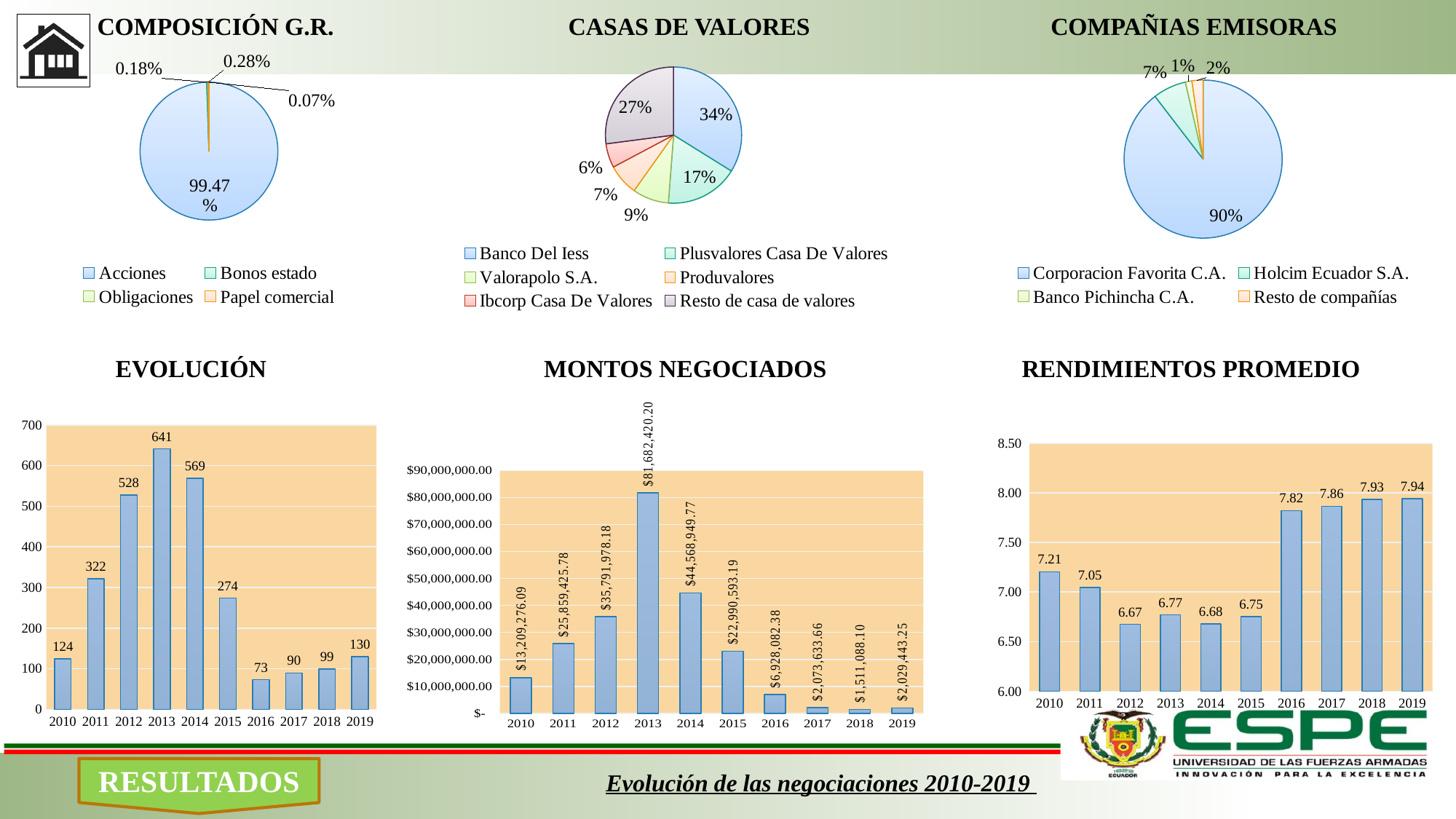
What kind of chart is the EVOLUCIÓN chart? Bar chart In the EVOLUCIÓN chart, which year has the lowest value? 2016 In the RENDIMIENTOS PROMEDIO chart, which is larger, the value for 2010 or the value for 2011? 2010 In the RENDIMIENTOS PROMEDIO chart, what is the value for 2019? 7.94 In the COMPAÑIAS EMISORAS pie chart, what share does Corporacion Favorita C.A. have? 90% In the MONTOS NEGOCIADOS chart, what is the value for 2014? $44,568,949.77 In the RENDIMIENTOS PROMEDIO chart, how many years are shown on the x axis? 10 In the CASAS DE VALORES pie chart, what share does Banco Del Iess have? 34% In the EVOLUCIÓN chart, what is the value for 2013? 641 In the MONTOS NEGOCIADOS chart, which year has the highest value? 2013 In the MONTOS NEGOCIADOS chart, which year has the lowest value? 2018 In the EVOLUCIÓN chart, what is the difference between the values for 2012 and 2011? 206